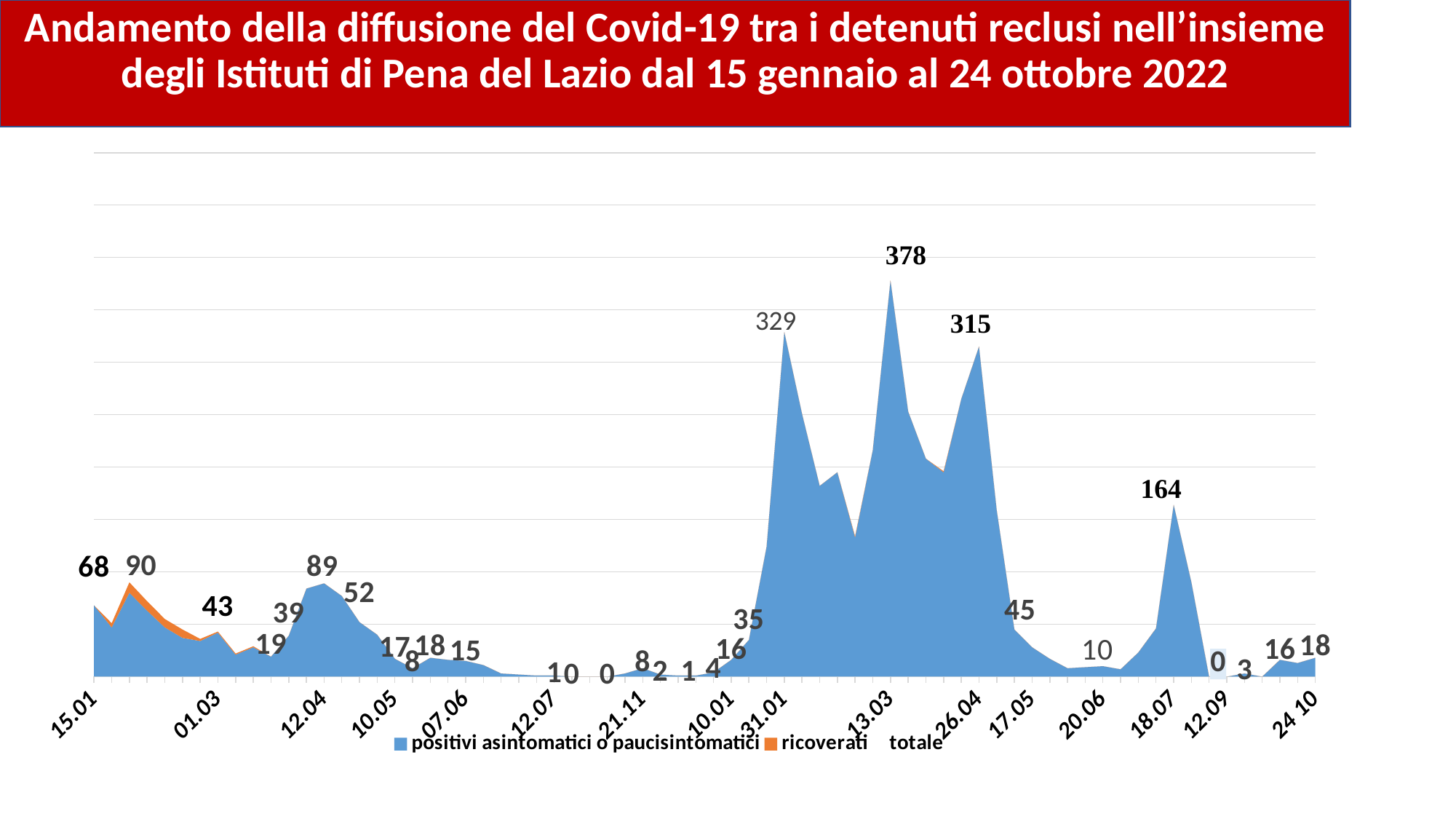
Do the values rise or fall between 18.07 and 12.09? Fall What is the highest value labelled on the chart? 378 What is the value labelled at the first point, 15.01, on the chart? 68 What kind of chart is shown on the slide? Area chart What is the value labelled at 26.04 on the chart? 315 What is the value labelled at 18.07 on the chart? 164 Which is larger, the value labelled 329 at 31.01 or the value labelled 315 at 26.04? 329 at 31.01 What is the value labelled at the last point, 24.10, on the chart? 18 What is the lowest value labelled on the chart? 0 What is the difference between the peak value 378 and the earlier peak of 329? 49 How many series does the legend list? 3 What is the value labelled at 13.03 on the chart? 378